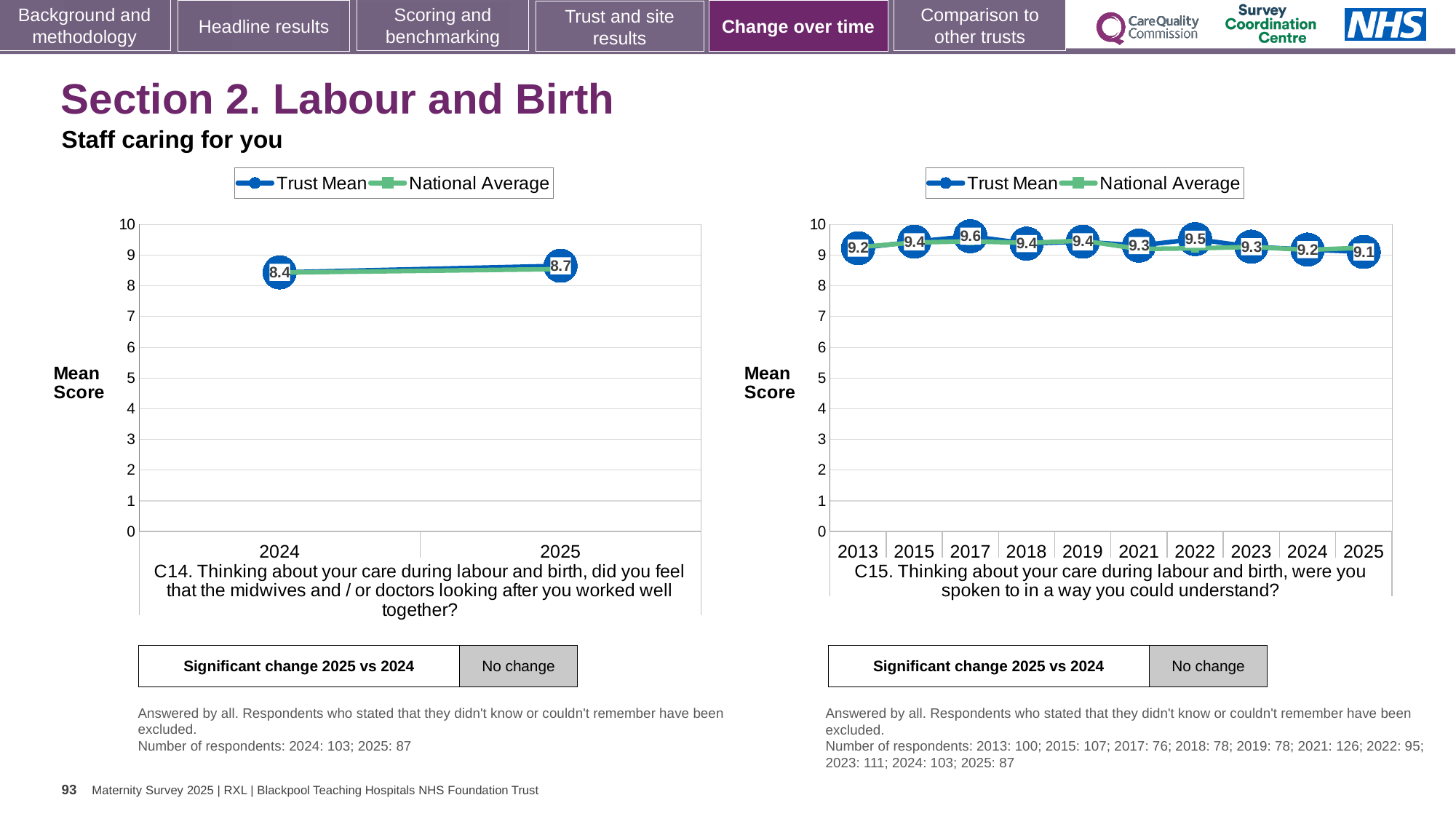
On the left chart (C14), what is the Trust Mean for 2025? 8.7 On the right chart (C15), which year has the lowest Trust Mean? 2025 On the right chart (C15), which year has the highest Trust Mean? 2017 On the left chart (C14), what is the Trust Mean for 2024? 8.4 On the right chart (C15), how many series does the legend list? 2 What type of chart is the left chart (C14)? line chart On the left chart (C14), what is the difference between the Trust Mean for 2025 and 2024? 0.3 On the left chart (C14), does the Trust Mean rise or fall from 2024 to 2025? rise On the left chart (C14), how many years are shown on the x axis? 2 On the right chart (C15), what is the Trust Mean for 2025? 9.1 On the right chart (C15), how many years are shown on the x axis? 10 On the right chart (C15), what is the Trust Mean for 2017? 9.6